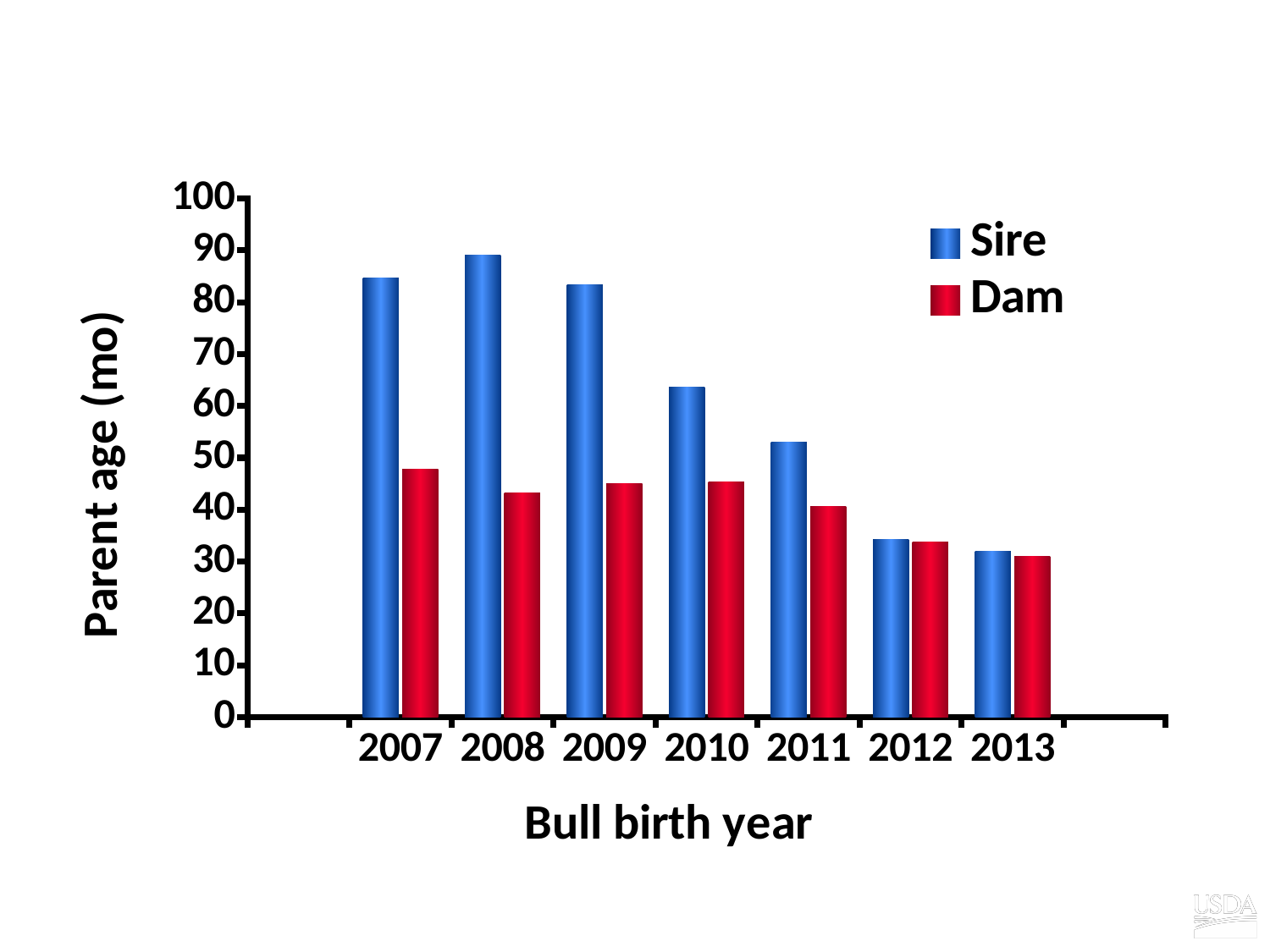
Is the Dam parent age for 2007 greater or less than 50? less In which bull birth year is the Dam parent age lowest? 2013 How many series does the legend list? 2 In which bull birth year is the Sire parent age lowest? 2013 What kind of chart is shown on the slide? bar chart How many bull birth years are shown on the x axis? 7 For bull birth year 2010, which is larger, the Sire or the Dam parent age? Sire Does the Sire parent age rise or fall from 2008 to 2013? fall Is the Sire parent age for 2012 greater or less than 40? less In which bull birth year is the Sire parent age highest? 2008 Is the Sire parent age for 2011 greater or less than 50? greater